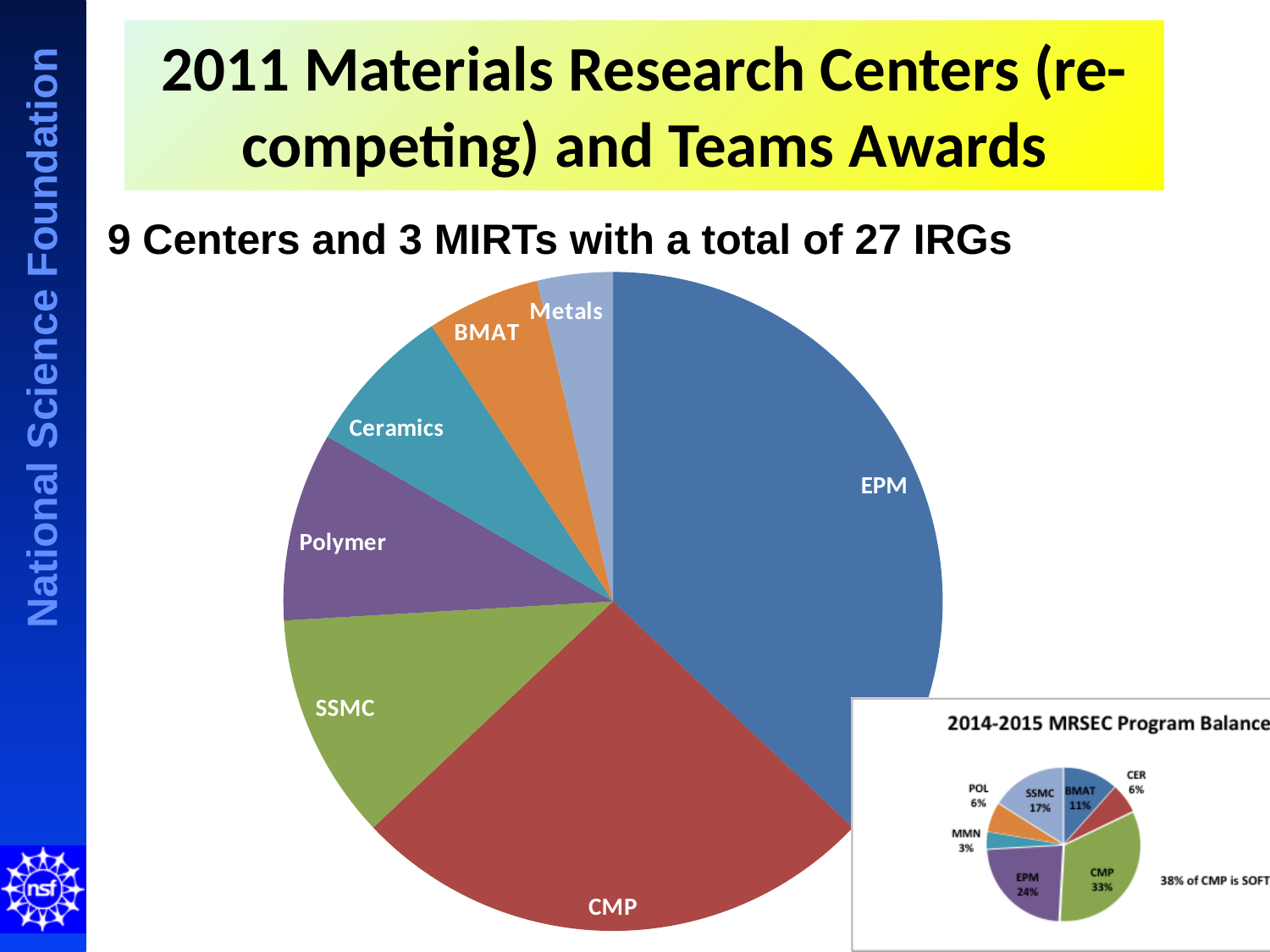
In the inset '2014-2015 MRSEC Program Balance' pie chart, what is the share for EPM? 24% In the large pie chart, which slice is larger, SSMC or Polymer? SSMC In the inset '2014-2015 MRSEC Program Balance' pie chart, what is the difference in percentage points between CMP and EPM? 9 How many slices does the large pie chart have? 7 In the inset '2014-2015 MRSEC Program Balance' pie chart, what is the share for CMP? 33% In the large pie chart, which category has the largest slice? EPM What kind of chart is the large chart on the slide? pie chart In the inset '2014-2015 MRSEC Program Balance' pie chart, which category has the smallest share? MMN In the large pie chart, which slice is larger, Polymer or Metals? Polymer In the large pie chart, which slice is larger, EPM or CMP? EPM What is the title of the inset pie chart in the lower right of the slide? 2014-2015 MRSEC Program Balance In the large pie chart, which category has the smallest slice? Metals